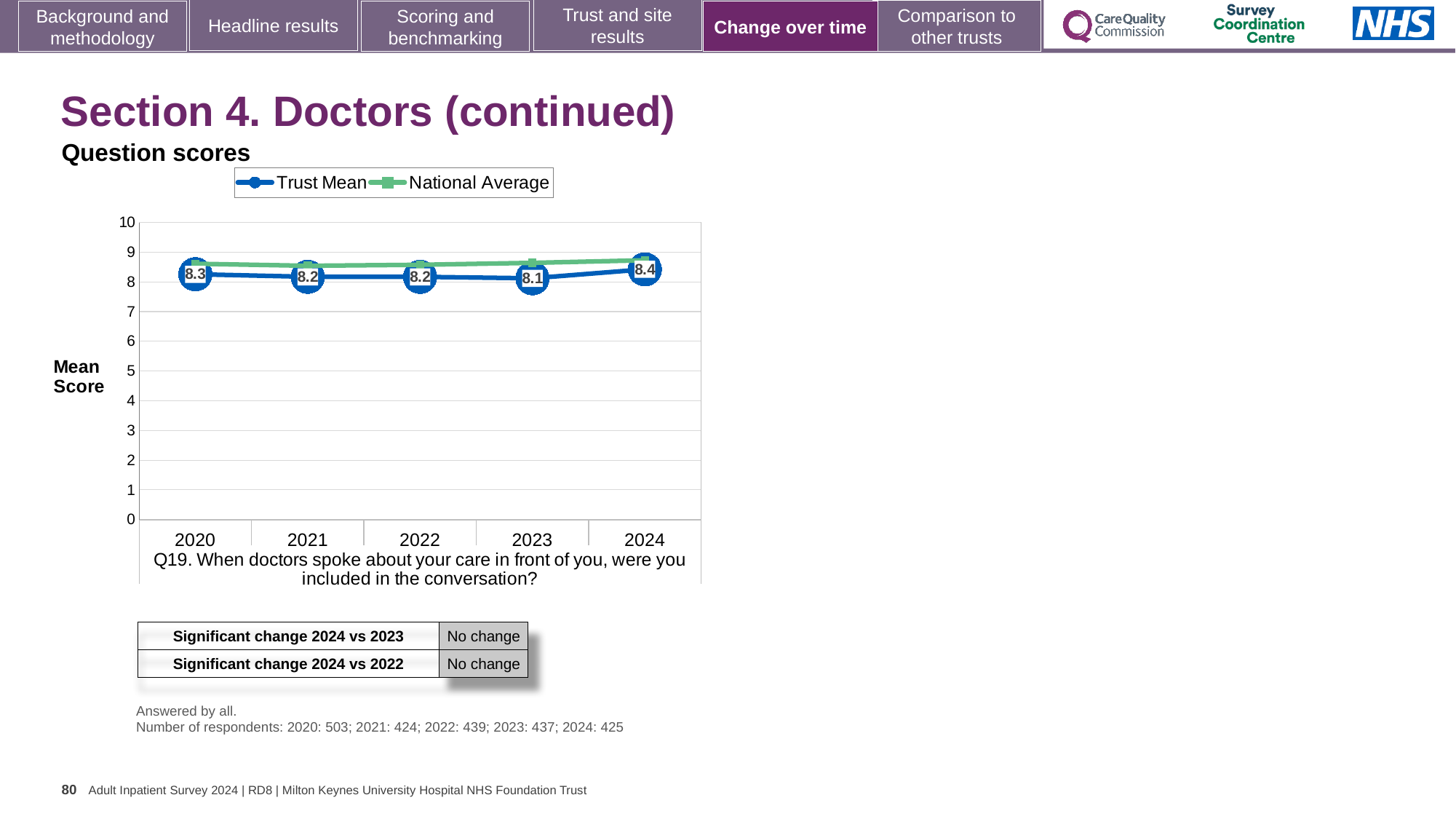
What is the Trust Mean score for 2024? 8.4 How many series does the legend list? 2 In which year is the Trust Mean score lowest? 2023 Which is larger, the Trust Mean score for 2020 or for 2021? 2020 What is the Trust Mean score for 2023? 8.1 Does the Trust Mean score rise or fall from 2023 to 2024? Rise What kind of chart is shown on the slide? Line chart In which year is the Trust Mean score highest? 2024 How many years are plotted on the x axis? 5 What is the Trust Mean score for 2020? 8.3 Is the National Average value for 2024 greater or less than 8? greater What is the difference between the Trust Mean scores for 2024 and 2023? 0.3